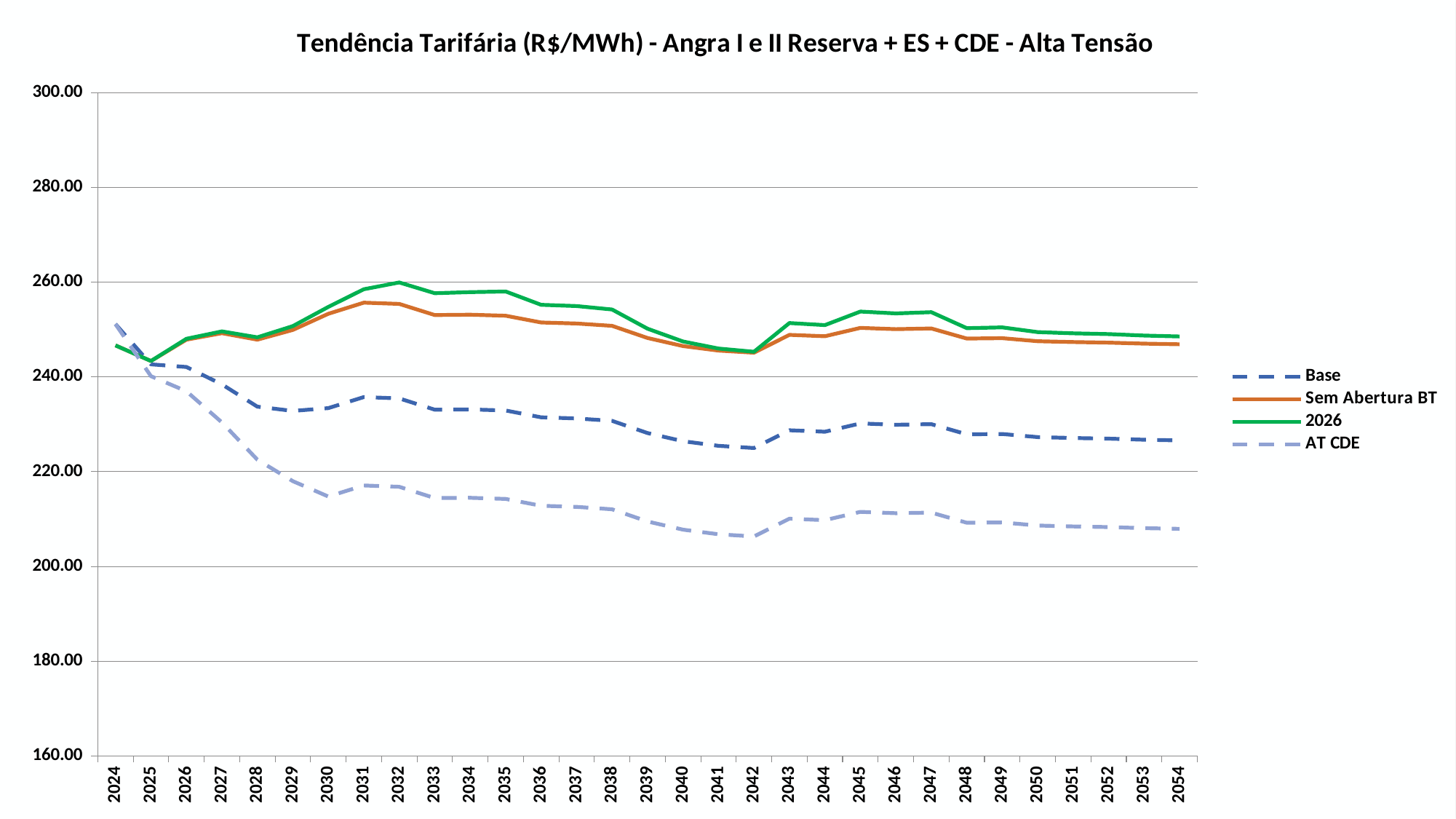
In 2030, which series has the higher value: Base or AT CDE? Base Is the value for Base in 2054 greater or less than 240? less Does the AT CDE series rise or fall from 2024 to 2030? fall Which series has the lowest value in 2045? AT CDE What kind of chart is shown on the slide? line chart How many years are plotted along the x axis? 31 How many series does the legend list? 4 What is the title of the chart? Tendência Tarifária (R$/MWh) - Angra I e II Reserva + ES + CDE - Alta Tensão Is the value for AT CDE in 2042 greater or less than 220? less Is the value for Sem Abertura BT in 2024 greater or less than 240? greater In 2035, which series has the higher value: 2026 or Sem Abertura BT? 2026